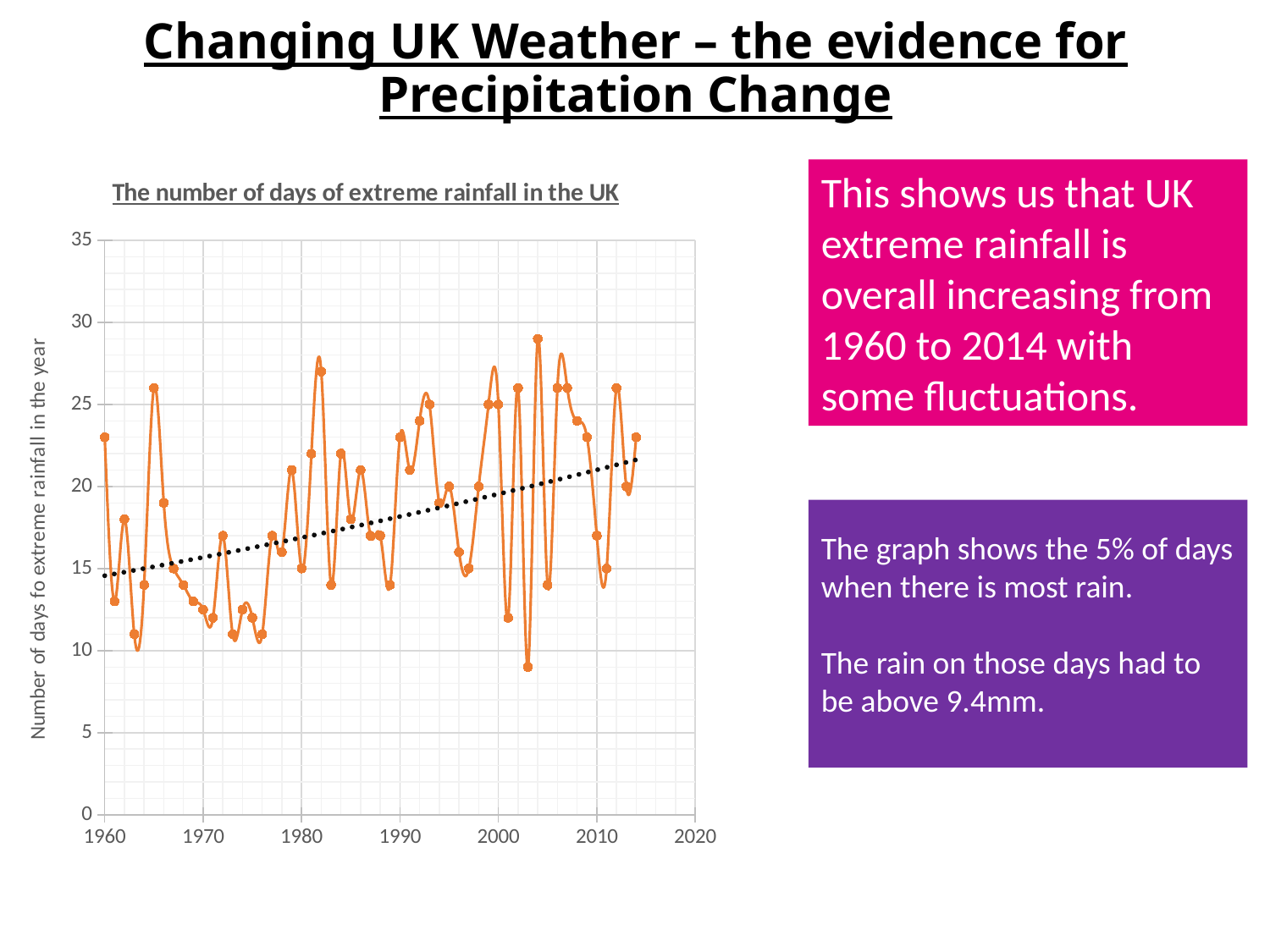
Is the value for 2004 greater or less than 25? greater Which year has the larger value, 2003 or 2004? 2004 Is the value for 1965 greater or less than 25? greater What is the label on the vertical axis of the chart? Number of days fo extreme rainfall in the year What type of chart is shown on the slide? line chart According to the dotted trend line, do the number of days of extreme rainfall rise or fall from 1960 to 2014? rise Is the value for 1975 greater or less than 15? less What is the title of the chart? The number of days of extreme rainfall in the UK Which year has the larger value, 1965 or 1970? 1965